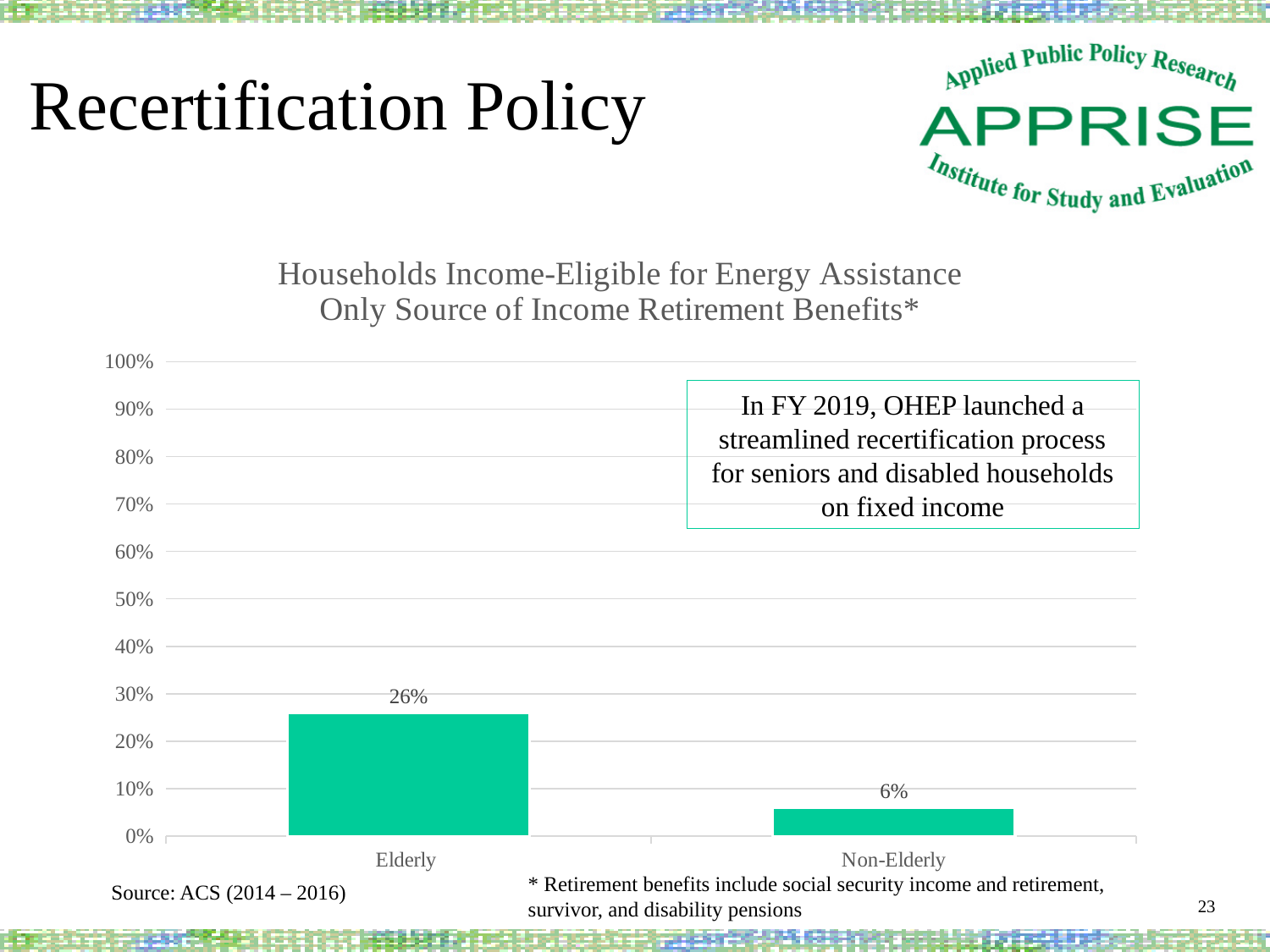
What is the title of the chart? Households Income-Eligible for Energy Assistance Only Source of Income Retirement Benefits* What is the value for Elderly? 26% What is the value for Non-Elderly? 6% Is the value for Elderly greater or less than 30%? less What kind of chart is shown on the slide? Bar chart What is the difference between the Elderly and Non-Elderly values? 20% How many categories are shown on the x axis? 2 Which category has the lowest value? Non-Elderly Is the value for Non-Elderly greater or less than 10%? less Which is larger, the value for Elderly or the value for Non-Elderly? Elderly What is the maximum value shown on the y axis? 100% Which category has the highest value? Elderly